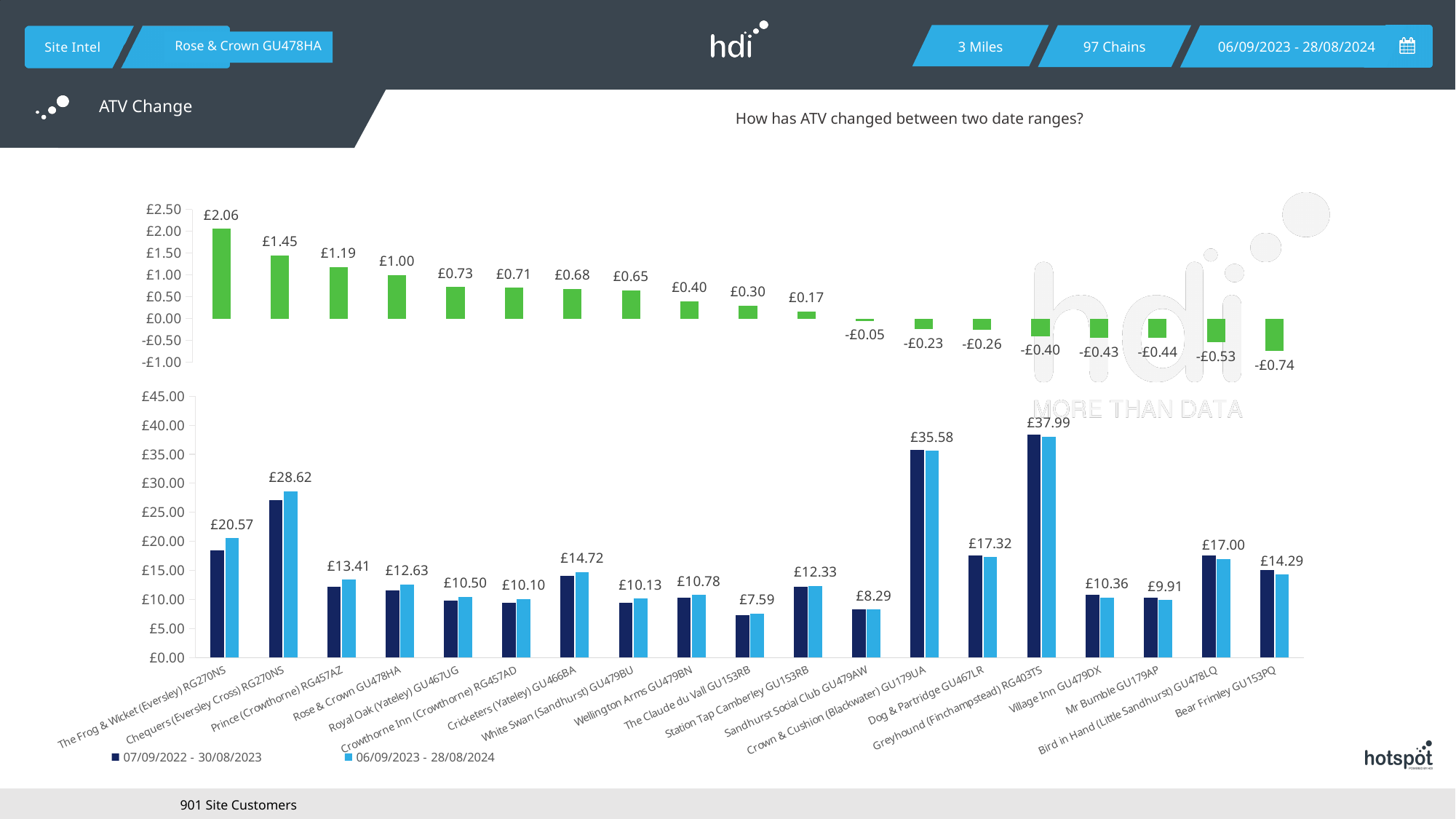
In the top chart, what is the ATV change shown for Greyhound (Finchampstead) RG403TS? -£0.40 In the top chart, what is the ATV change shown for The Frog & Wicket (Eversley) RG270NS? £2.06 What kind of chart is the bottom chart? bar chart In the bottom chart, is the 07/09/2022 - 30/08/2023 value for Chequers (Eversley Cross) RG270NS greater or less than £25.00? greater In the top chart, do the ATV change values rise or fall from left to right? fall What is the first series listed in the legend of the bottom chart? 07/09/2022 - 30/08/2023 How many series does the legend of the bottom chart list? 2 How many sites are plotted in the top chart? 19 In the top chart, which site has the highest ATV change? The Frog & Wicket (Eversley) RG270NS In the top chart, what is the difference between the ATV change for Chequers (Eversley Cross) RG270NS and Prince (Crowthorne) RG457AZ? £0.26 In the top chart, which site has the lowest ATV change? Bear Frimley GU153PQ